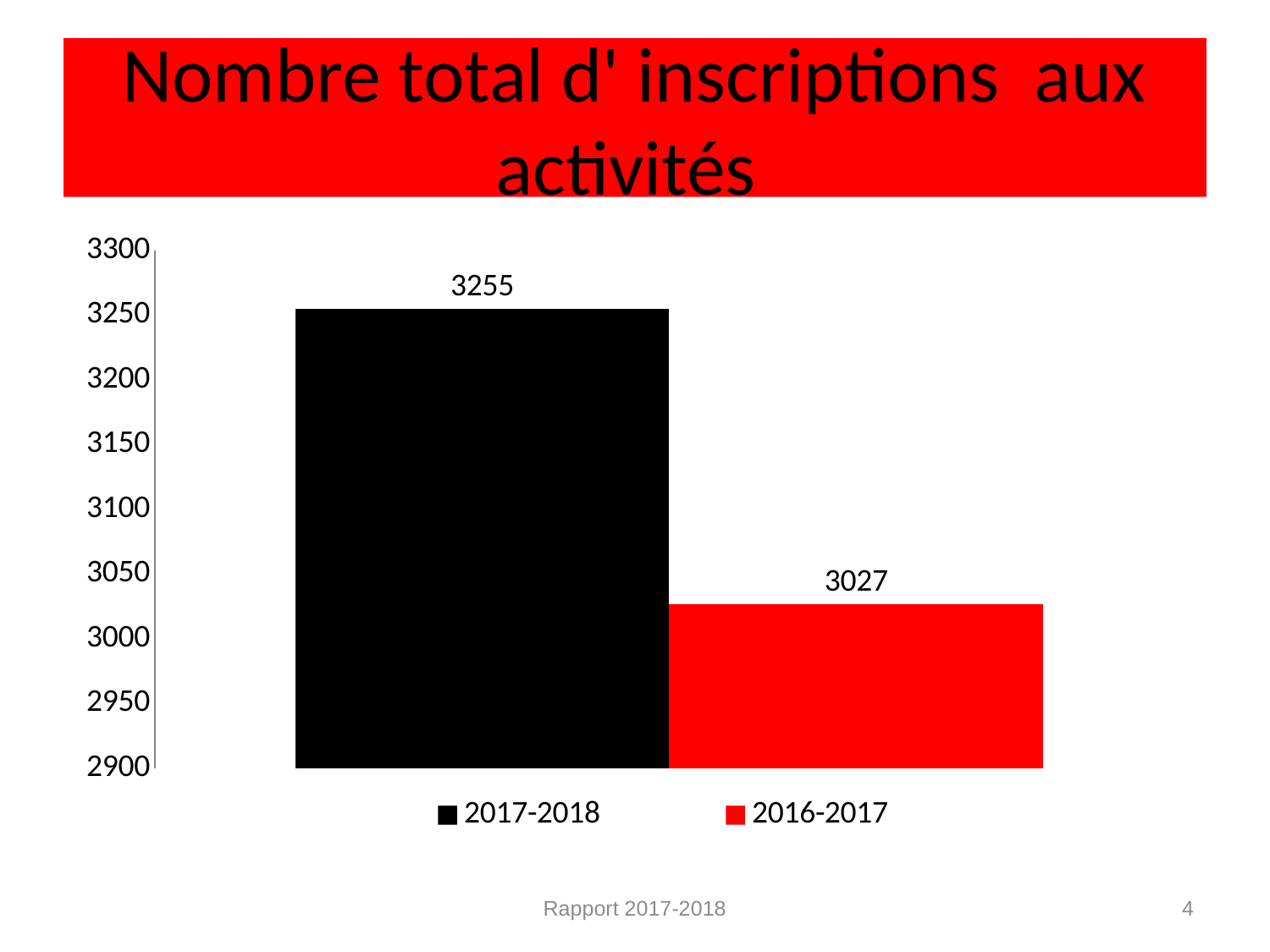
Which series has the highest value? 2017-2018 Is the value for 2016-2017 greater or less than 3050? less Which series has the lowest value? 2016-2017 What is the difference between the 2017-2018 and 2016-2017 values? 228 What colour is the bar for 2016-2017? red Is the value for 2017-2018 greater or less than 3200? greater What is the value for 2016-2017? 3027 What kind of chart is shown on the slide? bar chart How many series does the legend list? 2 How many bars are plotted on the chart? 2 Which is larger, the value for 2017-2018 or for 2016-2017? 2017-2018 What is the value for 2017-2018? 3255